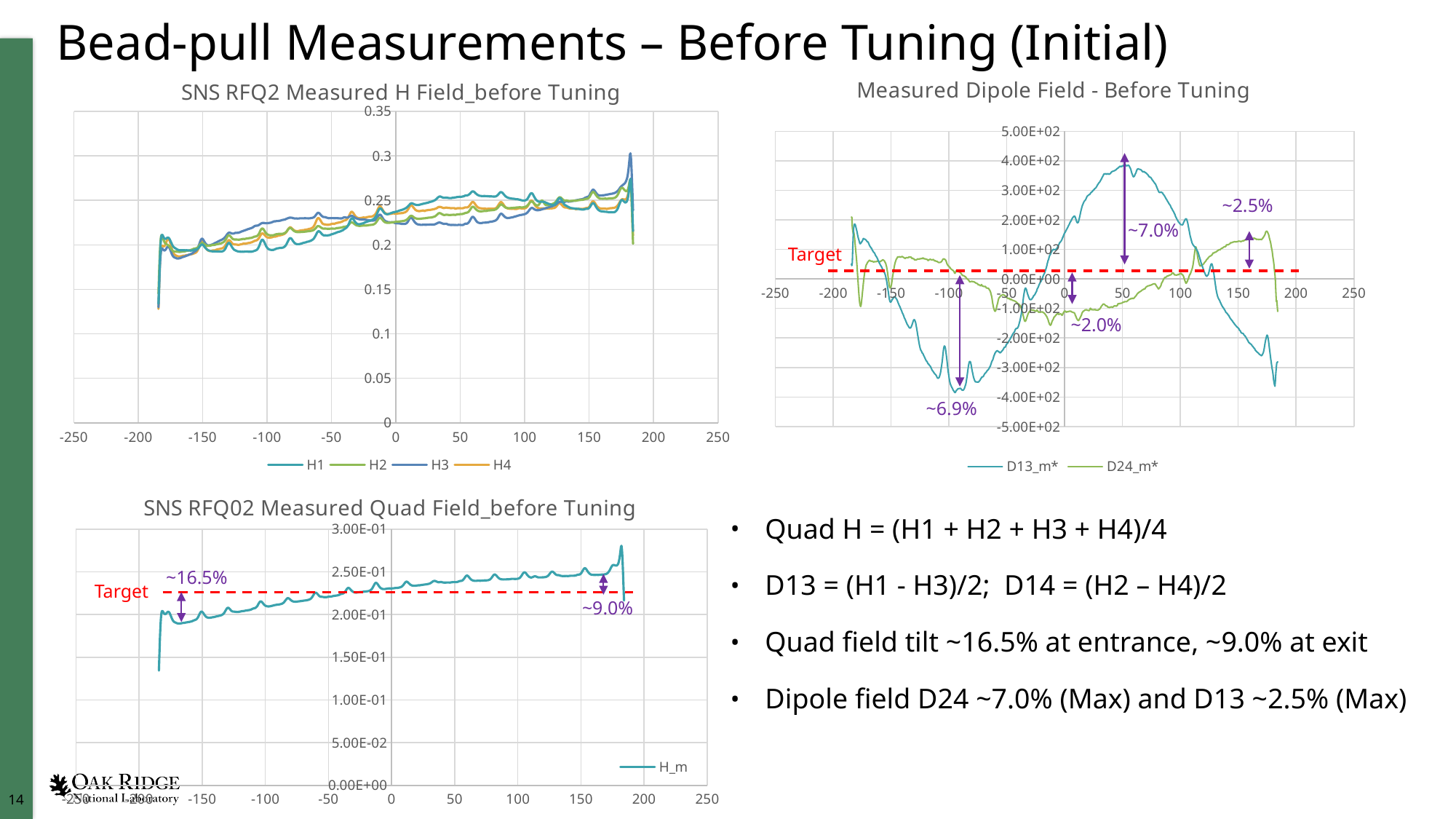
How many series does the legend of the 'Measured Dipole Field - Before Tuning' chart list? 2 In the 'SNS RFQ02 Measured Quad Field_before Tuning' chart, does the H_m value generally rise or fall from x = -150 to x = 150? rise In the 'Measured Dipole Field - Before Tuning' chart, is the D13_m* value at x = -100 greater or less than -2.00E+02? less In the 'SNS RFQ2 Measured H Field_before Tuning' chart, is the H1 value at x = 100 greater or less than 0.2? greater In the 'Measured Dipole Field - Before Tuning' chart, is the D13_m* value at x = 50 greater or less than 3.00E+02? greater How many series does the legend of the 'SNS RFQ2 Measured H Field_before Tuning' chart list? 4 How many series does the legend of the 'SNS RFQ02 Measured Quad Field_before Tuning' chart list? 1 What are the legend entries of the 'Measured Dipole Field - Before Tuning' chart? D13_m* and D24_m* In the 'SNS RFQ2 Measured H Field_before Tuning' chart, do the H1–H4 values generally rise or fall from x = -150 to x = 150? rise What is the title of the chart in the bottom-left of the slide? SNS RFQ02 Measured Quad Field_before Tuning What kind of chart is the 'SNS RFQ02 Measured Quad Field_before Tuning' chart? line chart